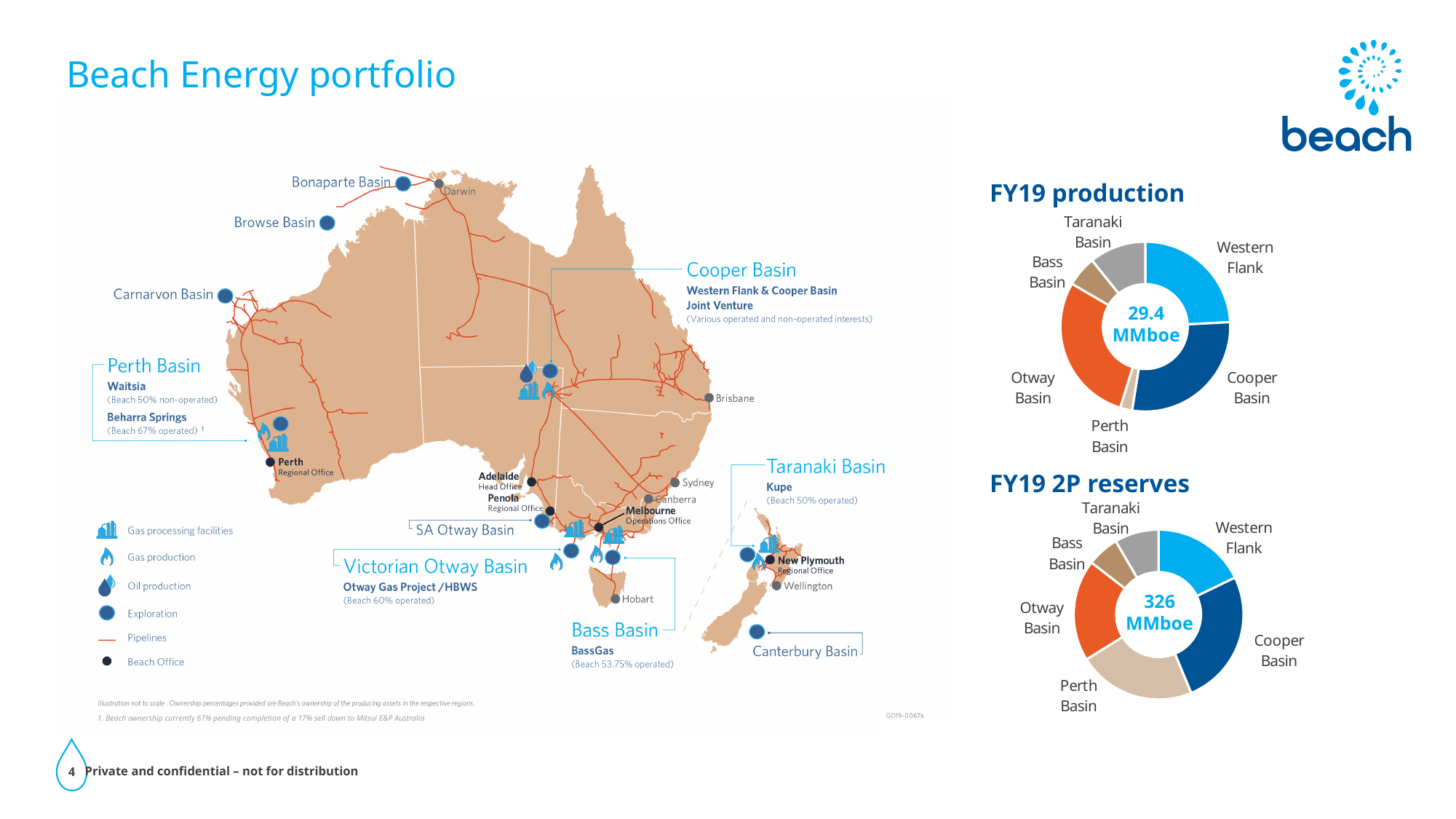
In the FY19 2P reserves chart, which slice is larger: Cooper Basin or Bass Basin? Cooper Basin What total value is shown in the centre of the FY19 2P reserves chart? 326 MMboe What kind of chart is the FY19 production chart? Donut (pie) chart In the FY19 production chart, which basin has the smallest slice? Perth Basin In the FY19 production chart, which slice is larger: Otway Basin or Perth Basin? Otway Basin What total value is shown in the centre of the FY19 production chart? 29.4 MMboe In the FY19 2P reserves chart, which slice is larger: Perth Basin or Taranaki Basin? Perth Basin How many basins/segments are shown in the FY19 production chart? 6 What is the title of the lower donut chart on the slide? FY19 2P reserves Which segment in the FY19 production chart is coloured grey? Taranaki Basin How many segments are shown in the FY19 2P reserves chart? 6